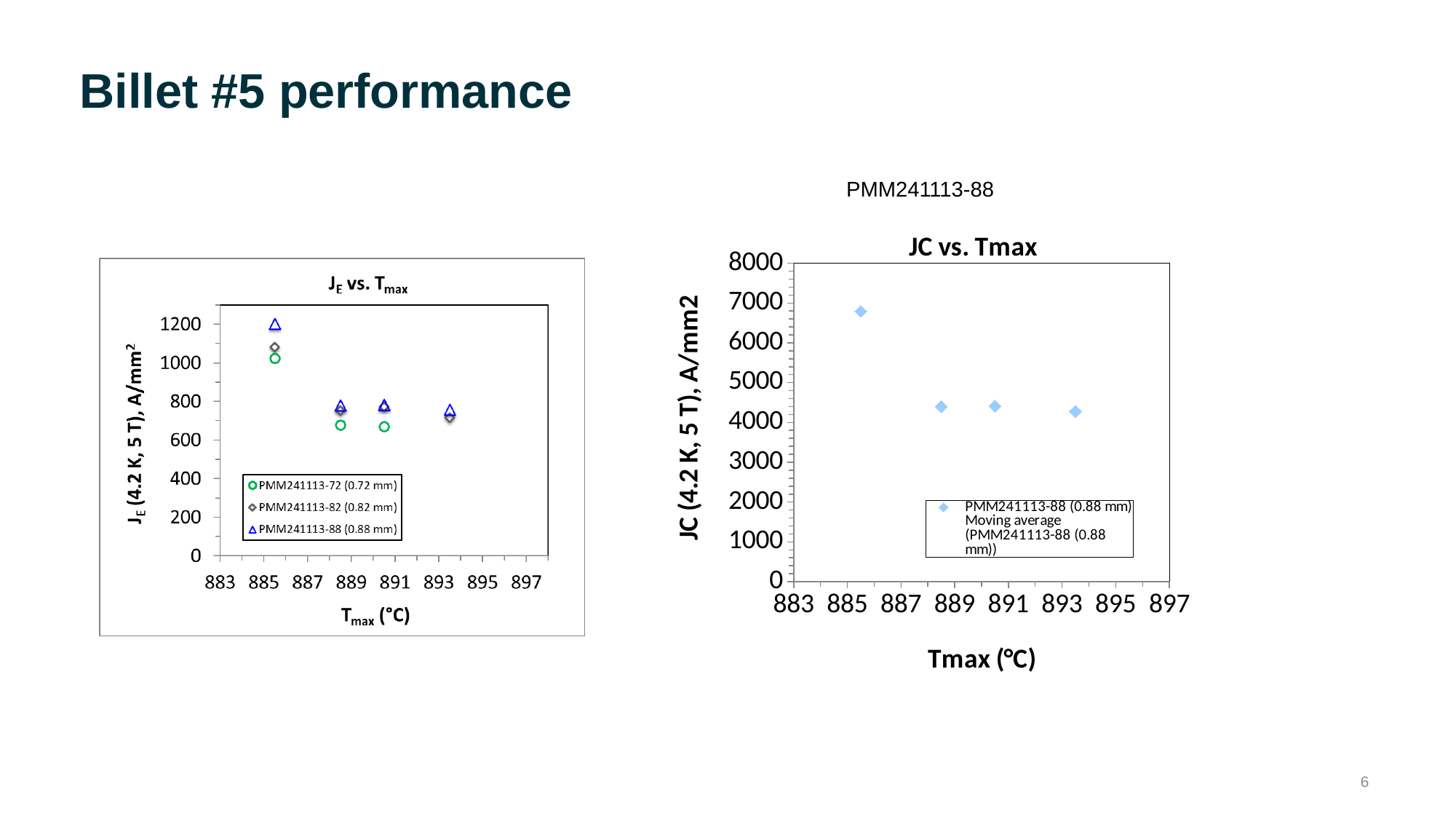
In the left chart "JE vs. Tmax", how many data points are plotted for the PMM241113-88 (0.88 mm) series? 4 In the right chart "JC vs. Tmax", is the JC value at the highest Tmax greater or less than 5000? less In the left chart "JE vs. Tmax", do the JE values rise or fall as Tmax increases? fall In the right chart "JC vs. Tmax", is the JC value at the lowest Tmax greater or less than 6000? greater How many entries does the legend of the right chart "JC vs. Tmax" list? 2 In the left chart "JE vs. Tmax", is the value for PMM241113-72 (0.72 mm) at the second-lowest Tmax greater or less than 800? less What is the title of the right chart? JC vs. Tmax In the left chart "JE vs. Tmax", at the lowest Tmax, which series has the larger JE value: PMM241113-72 (0.72 mm) or PMM241113-88 (0.88 mm)? PMM241113-88 (0.88 mm) How many series does the legend of the left chart "JE vs. Tmax" list? 3 What kind of chart is the left chart titled "JE vs. Tmax"? Scatter chart How many data points are plotted in the right chart "JC vs. Tmax"? 4